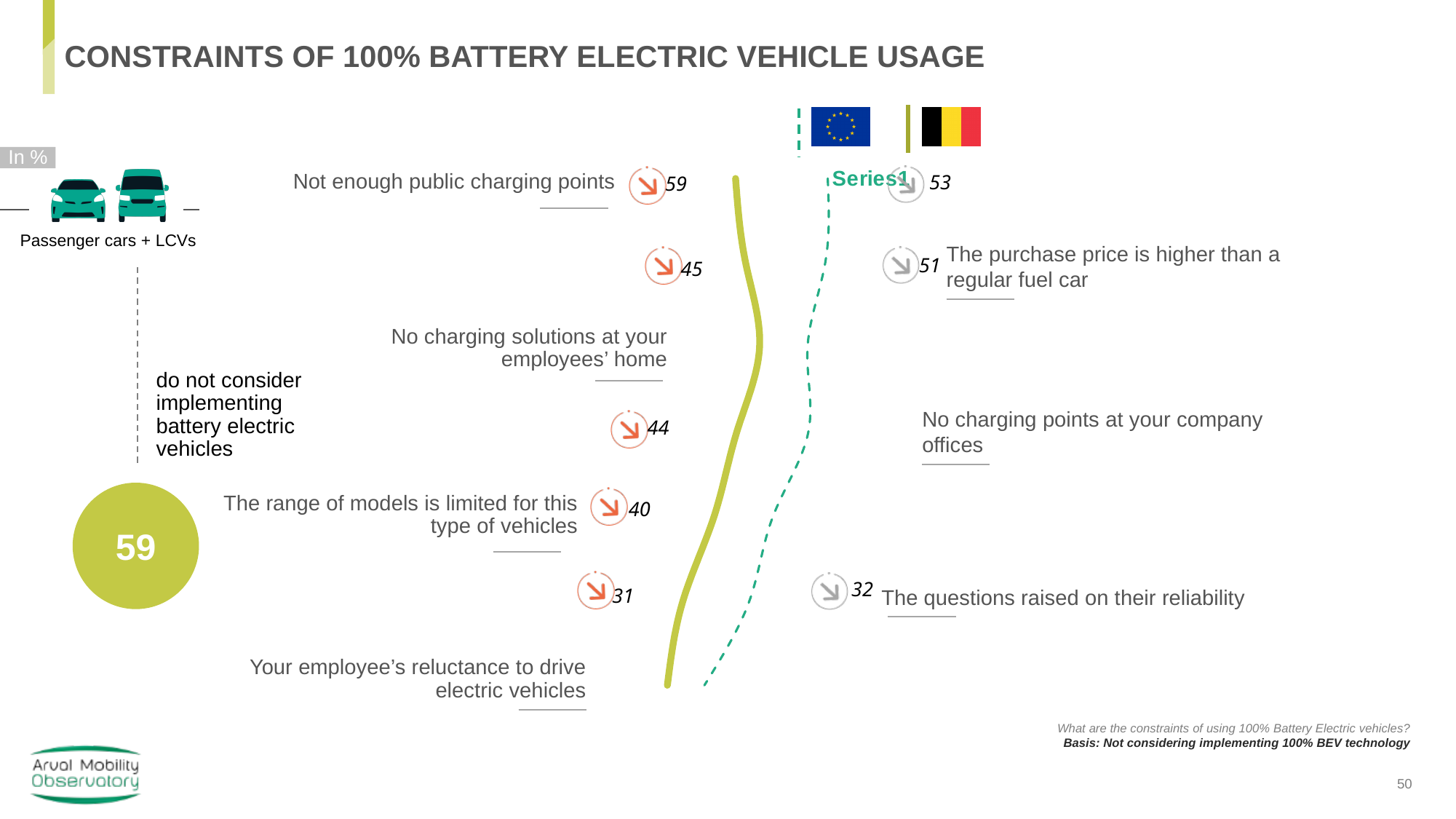
In what unit are the chart values expressed, according to the label at the top left? In % What value is shown next to "The purchase price is higher than a regular fuel car"? 51 What is the lowest data value printed on the chart? 31 What number is shown in the large green circle on the left of the slide? 59 What is the highest data value printed on the chart? 59 What is the difference between the value for "Not enough public charging points" (59) and the value for "The range of models is limited for this type of vehicles" (40)? 19 Which has the larger value: "Not enough public charging points" or "The range of models is limited for this type of vehicles"? Not enough public charging points What kind of chart is shown on the slide? line chart How many data labels are printed on the chart? 8 What value is shown next to "The questions raised on their reliability"? 32 What value is shown next to "The range of models is limited for this type of vehicles"? 40 What value is shown next to "Not enough public charging points"? 59